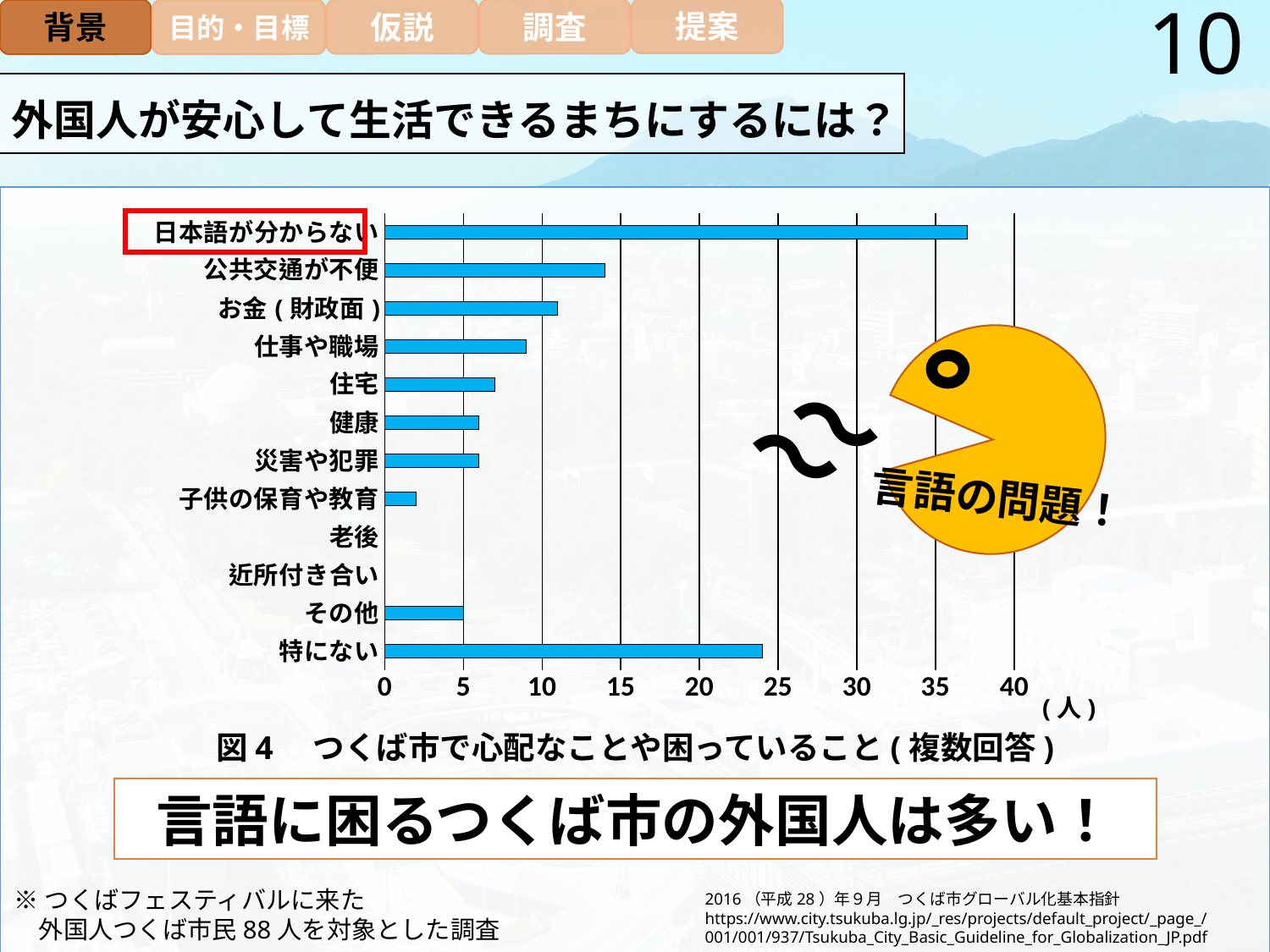
Which is larger, the value for 公共交通が不便 or the value for お金(財政面)? 公共交通が不便 Which is larger, the value for 日本語が分からない or the value for 特にない? 日本語が分からない Is the value for 日本語が分からない greater or less than 35? greater Is the value for 仕事や職場 greater or less than 10? less What unit is shown at the end of the horizontal axis of the chart? (人) What is the value for その他 in the chart? 5 How many categories are listed on the vertical axis of the chart? 12 Is the value for 特にない greater or less than 25? less What kind of chart is shown on the slide? bar chart Which category has the longest bar in the chart? 日本語が分からない